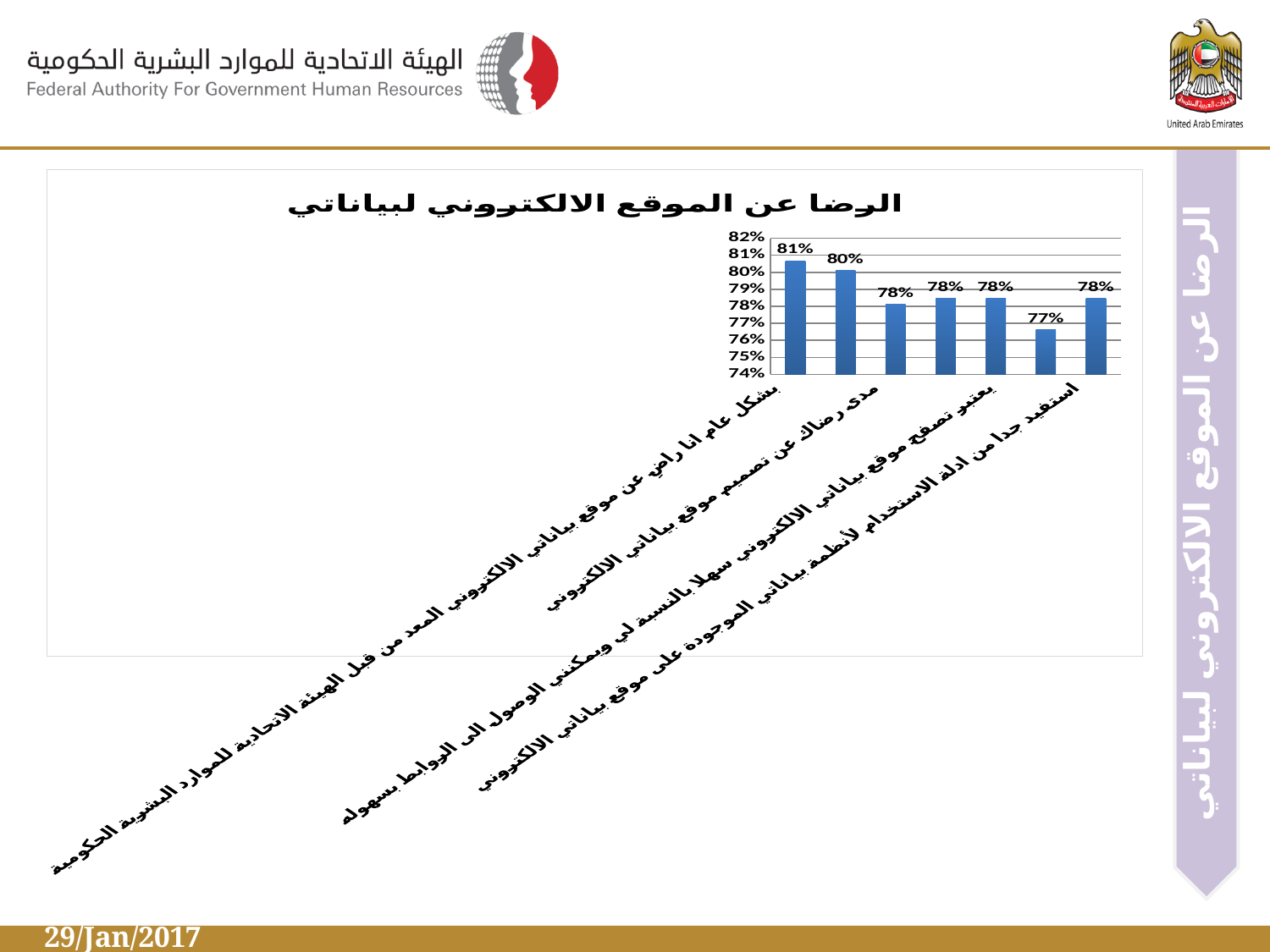
What is the value of the second bar from the left? 80% What is the title of the chart? الرضا عن الموقع الالكتروني لبياناتي Which bar has the lowest value in the chart? the sixth bar, 77% How many bars are plotted in the chart? 7 How many bars in the chart have a value of 78%? 4 What is the value of the first (leftmost) bar in the chart? 81% What is the difference between the first bar (81%) and the second bar (80%)? 1 percentage point Which bar has the highest value in the chart? the first (leftmost) bar, 81% What is the value of the sixth bar from the left? 77% Which is larger, the second bar or the third bar? the second bar (80%) What is the difference between the highest and lowest values in the chart? 4 percentage points What type of chart is shown on the slide? bar chart